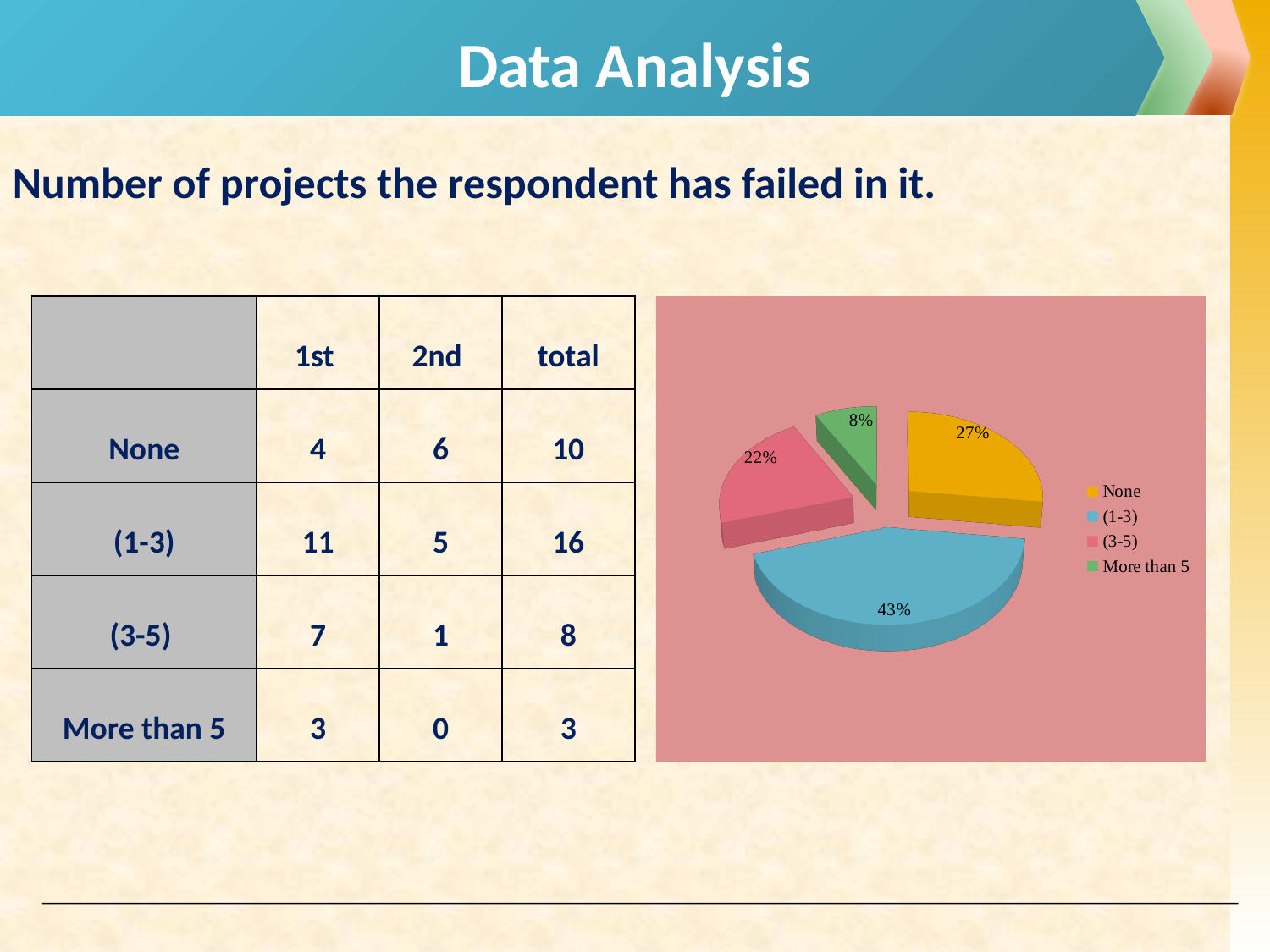
What colour is the (1-3) slice in the pie chart? blue What percentage of the pie chart does the None slice represent? 27% Which category has the smallest slice in the pie chart? More than 5 How many slices does the pie chart have? 4 What kind of chart is shown on the slide? pie chart What is the difference in percentage points between the (1-3) slice and the None slice? 16 Which category has the largest slice in the pie chart? (1-3) What percentage of the pie chart does the More than 5 slice represent? 8% What percentage of the pie chart does the (1-3) slice represent? 43% Which slice is larger in the pie chart, None or (3-5)? None How many entries does the pie chart legend list? 4 What percentage of the pie chart does the (3-5) slice represent? 22%